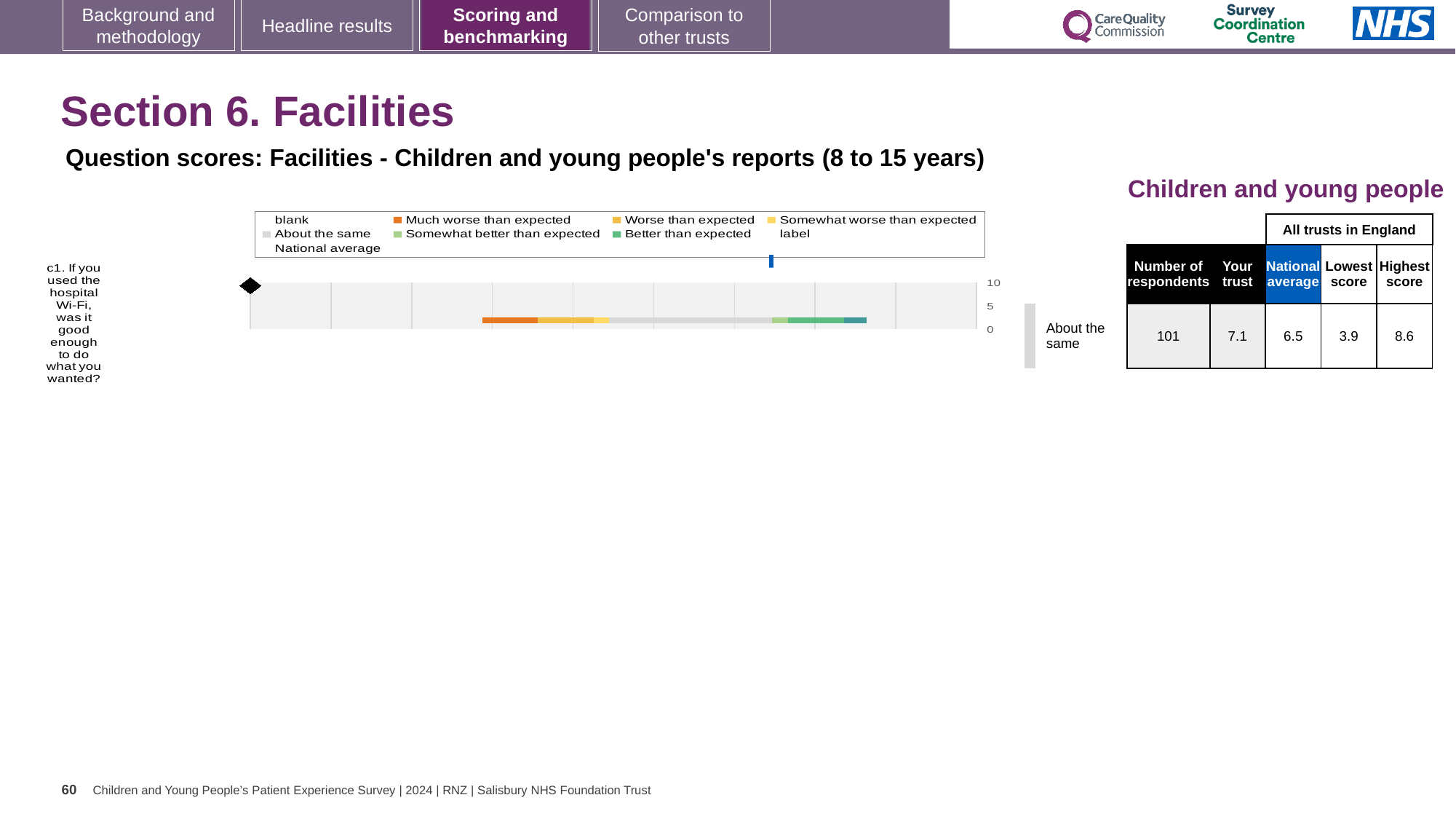
What benchmark category is the trust's result for question c1 placed in? About the same What is the national average score for question c1? 6.5 How many respondents answered question c1? 101 What is the highest score among all trusts in England for question c1? 8.6 What is the 'Your trust' score for question c1? 7.1 What is the lowest score among all trusts in England for question c1? 3.9 What is the difference between the trust's score and the national average for question c1? 0.6 Which survey question is plotted in the chart? c1. If you used the hospital Wi-Fi, was it good enough to do what you wanted? Is the trust's score for question c1 higher or lower than the national average? higher What is the difference between the highest and lowest scores among all trusts in England for question c1? 4.7 How many survey questions are plotted in the chart? 1 What kind of chart is shown on the slide? bar chart